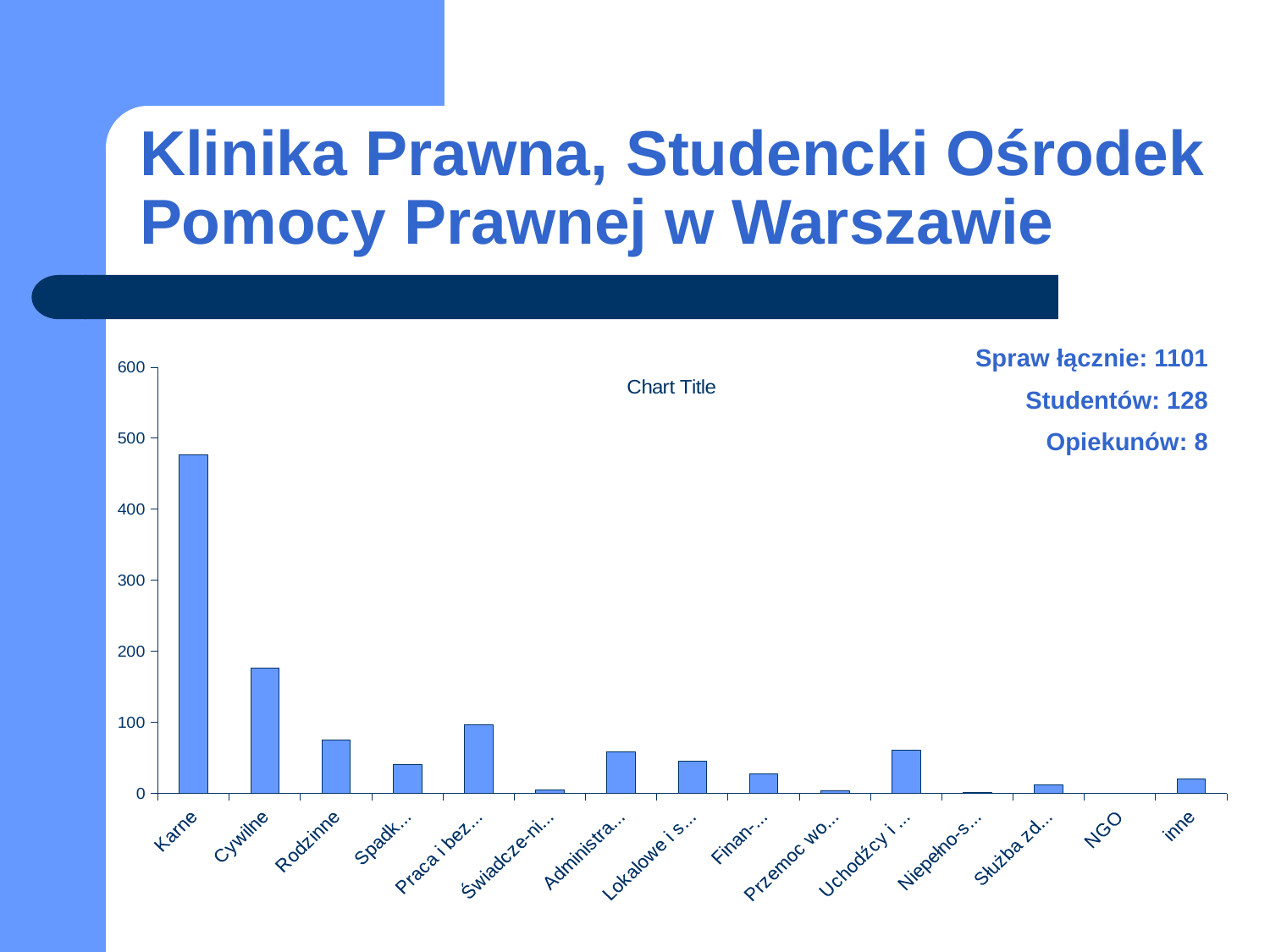
Which category has the highest bar in the chart? Karne Is the value for inne greater or less than 100? less Is the value for Cywilne greater or less than 100? greater Which is larger, the value for Karne or the value for Cywilne? Karne What is the title shown on the chart? Chart Title What is the highest value shown on the chart's vertical axis? 600 Is the value for Cywilne greater or less than 200? less Which is larger, the value for Rodzinne or the value for Cywilne? Cywilne What kind of chart is shown on the slide? bar chart How many categories are plotted on the x axis of the chart? 15